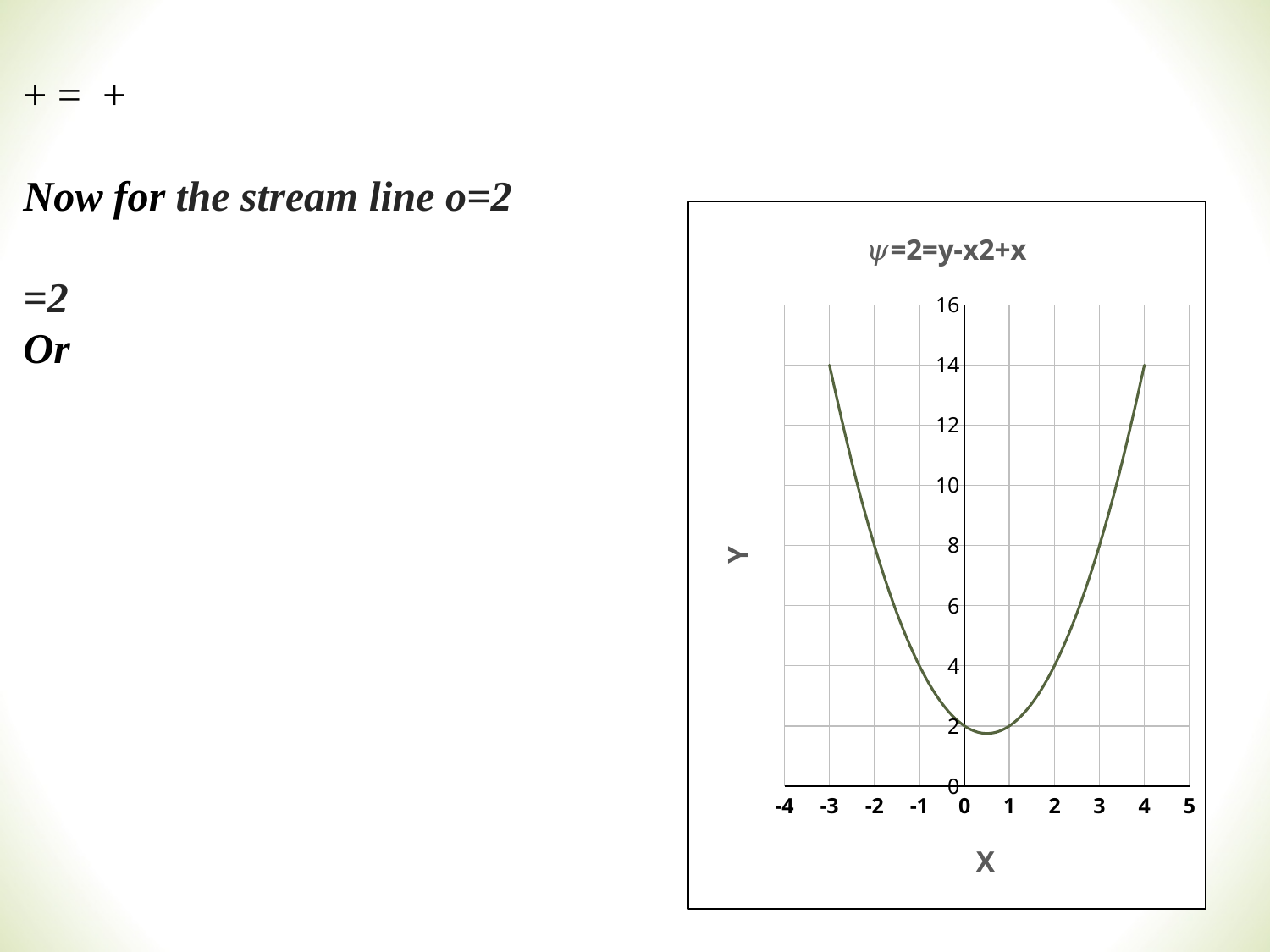
What is the Y value of the curve at X = -2? 8 Is the Y value of the curve at X = -1 greater or less than 6? less What kind of chart is shown on the slide? line chart What is the Y value of the curve at X = -3? 14 Is the lowest point of the curve greater or less than 4? less Is the Y value of the curve at X = 2 greater or less than 6? less What is the Y value of the curve at X = 4? 14 What is the label of the vertical axis? Y Does the curve rise or fall as X increases from 1 to 4? rise What is the title of the chart? ψ=2=y-x2+x What is the Y value of the curve where it crosses the vertical axis (X = 0)? 2 What is the Y value of the curve at X = 3? 8